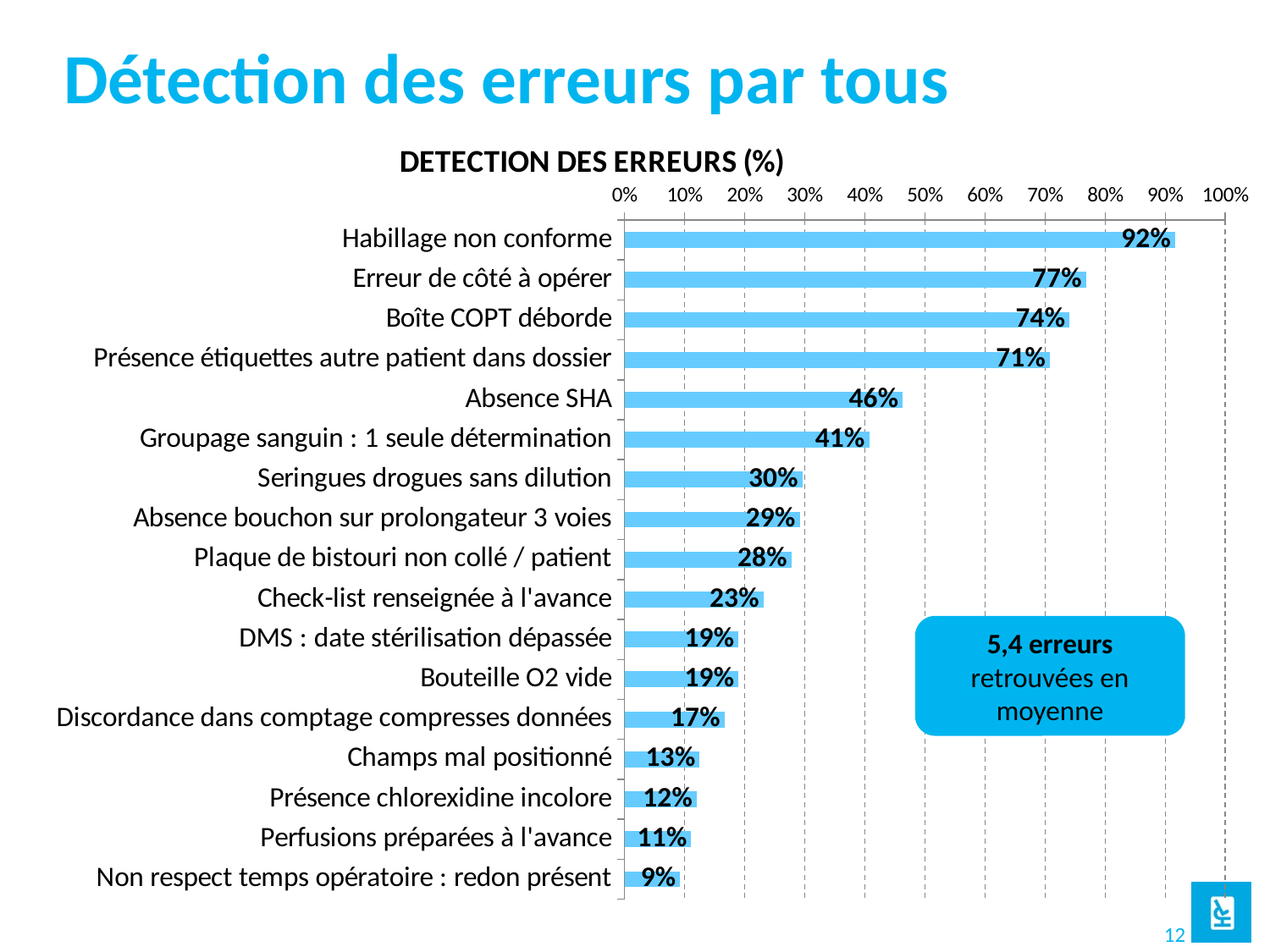
Is the value for Présence étiquettes autre patient dans dossier greater or less than 60%? greater What kind of chart is shown? Bar chart Which category has the lowest value? Non respect temps opératoire : redon présent Which is larger, Absence SHA or Groupage sanguin : 1 seule détermination? Absence SHA What is the title of the chart? DETECTION DES ERREURS (%) How many categories are shown in the chart? 17 What is the value for Habillage non conforme? 92% What is the difference between Erreur de côté à opérer and Boîte COPT déborde? 3% What is the value for Check-list renseignée à l'avance? 23% What is the difference between Habillage non conforme and Non respect temps opératoire : redon présent? 83% Which category has the highest value? Habillage non conforme What is the value for Absence SHA? 46%